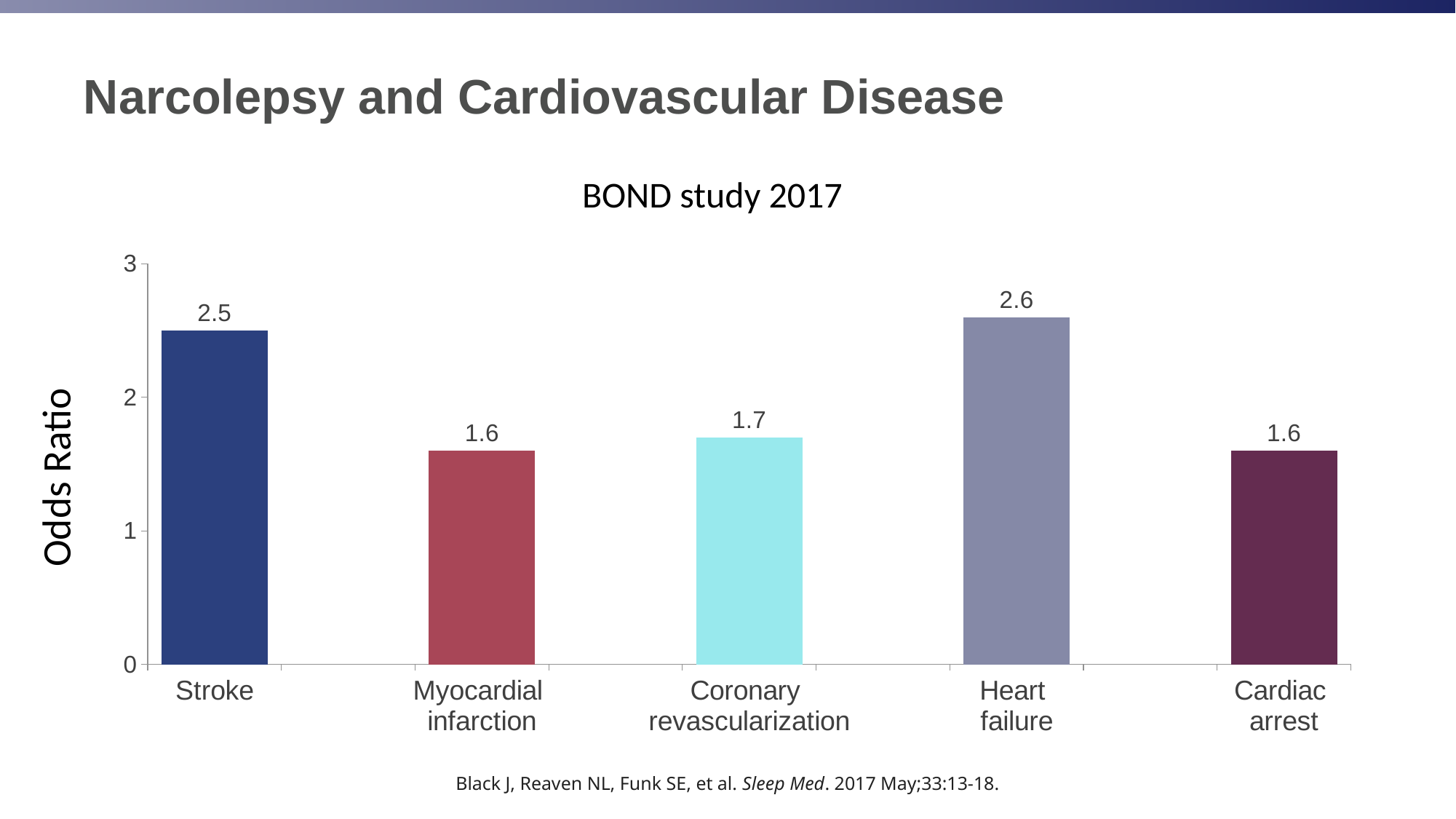
What is the difference between the odds ratios for Stroke and Coronary revascularization? 0.8 What kind of chart is shown on the slide? Bar chart Is the odds ratio for Myocardial infarction greater or less than 2? less What is the odds ratio for Cardiac arrest? 1.6 What is the title of the chart? BOND study 2017 What is the odds ratio for Heart failure? 2.6 How many categories are shown on the chart? 5 What is the odds ratio for Stroke? 2.5 Which has a larger odds ratio, Stroke or Cardiac arrest? Stroke What is the odds ratio for Coronary revascularization? 1.7 What is the difference between the odds ratios for Heart failure and Myocardial infarction? 1.0 Which category has the highest odds ratio? Heart failure